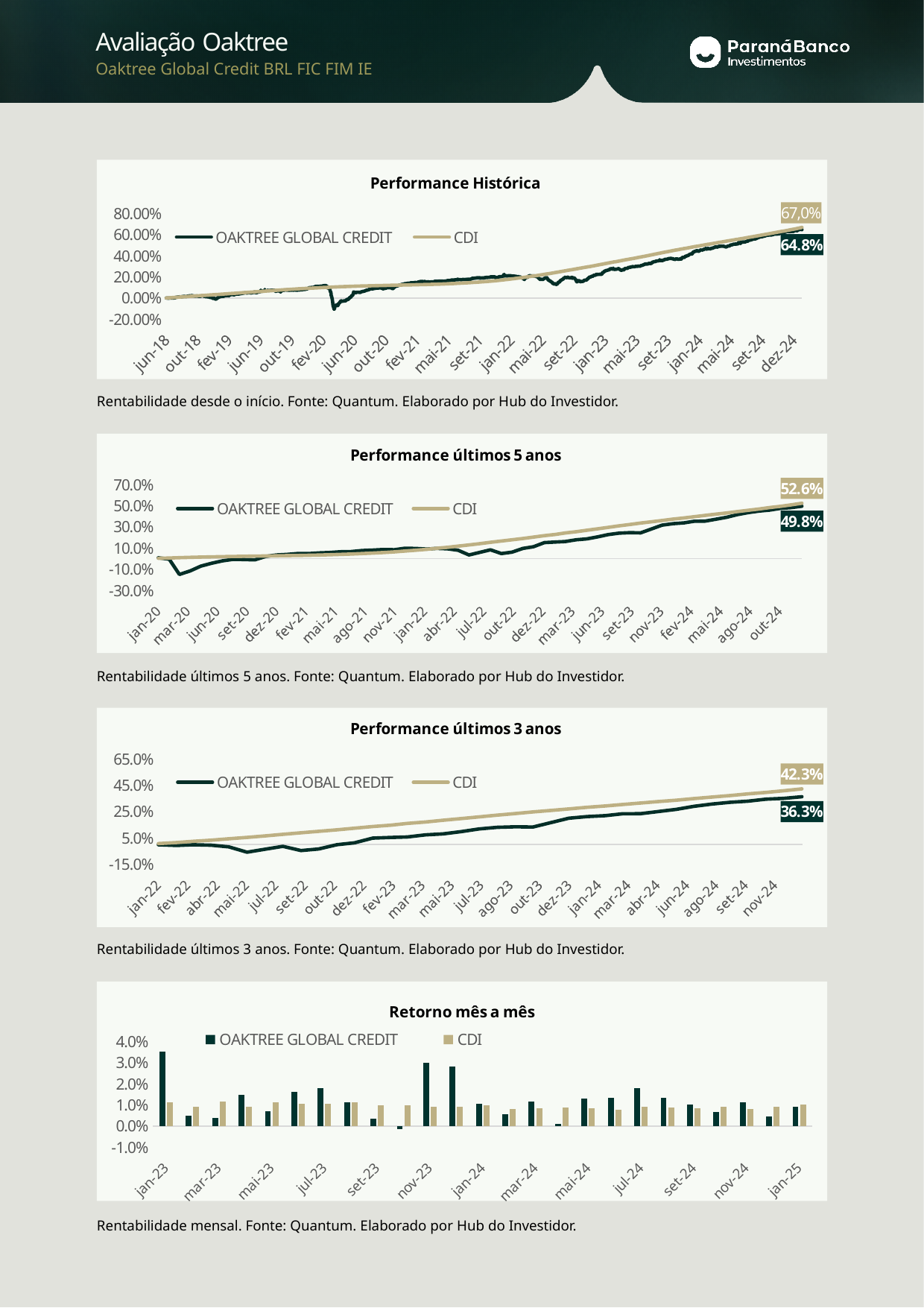
In the 'Performance últimos 5 anos' chart, what is the final value shown for CDI? 52.6% In the 'Performance últimos 5 anos' chart, what is the difference in percentage points between the final CDI value and the final OAKTREE GLOBAL CREDIT value? 2.8 percentage points In the 'Performance Histórica' chart, what is the final value shown for OAKTREE GLOBAL CREDIT? 64.8% In the 'Performance últimos 3 anos' chart, what is the final value shown for OAKTREE GLOBAL CREDIT? 36.3% In the 'Performance Histórica' chart, which series ends higher, OAKTREE GLOBAL CREDIT or CDI? CDI In the 'Retorno mês a mês' chart, is the OAKTREE GLOBAL CREDIT value for jan-23 greater or less than 3.0%? greater In the 'Performance últimos 3 anos' chart, what is the difference in percentage points between the final CDI value and the final OAKTREE GLOBAL CREDIT value? 6.0 percentage points How many series does the legend of the 'Performance últimos 3 anos' chart list? 2 In the 'Retorno mês a mês' chart, which month has the highest OAKTREE GLOBAL CREDIT bar? jan-23 In the 'Performance últimos 5 anos' chart, what is the final value shown for OAKTREE GLOBAL CREDIT? 49.8% What kind of chart is 'Retorno mês a mês'? Bar chart In the 'Performance Histórica' chart, what is the final value shown for CDI? 67,0%